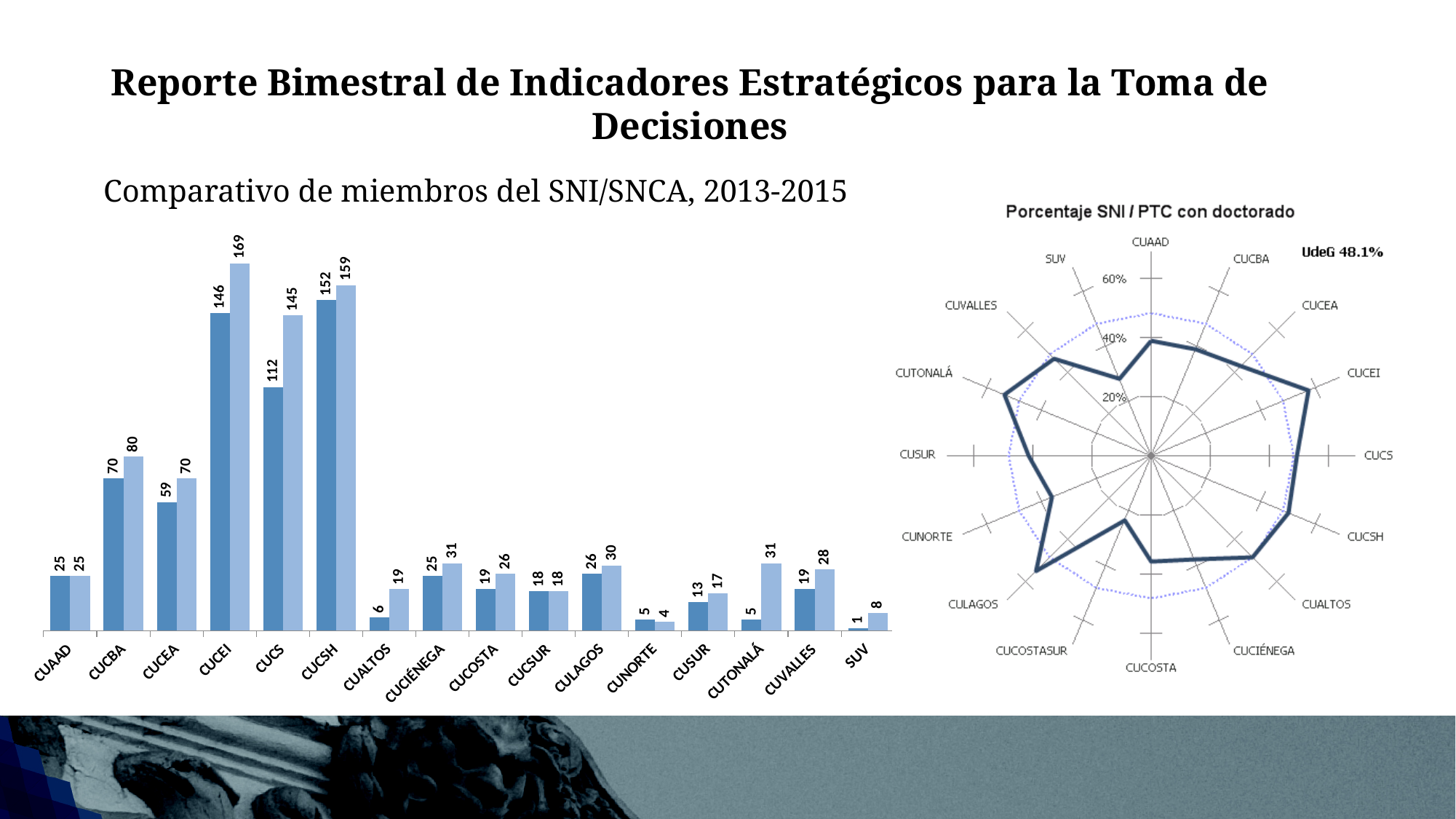
In the bar chart 'Comparativo de miembros del SNI/SNCA, 2013-2015', what is the value of the lighter blue bar for CUCEI? 169 In the bar chart 'Comparativo de miembros del SNI/SNCA, 2013-2015', how many categories are shown on the x axis? 16 In the bar chart 'Comparativo de miembros del SNI/SNCA, 2013-2015', what is the value of the darker blue bar for CUCS? 112 In the bar chart 'Comparativo de miembros del SNI/SNCA, 2013-2015', which category has the highest lighter blue bar? CUCEI In the bar chart 'Comparativo de miembros del SNI/SNCA, 2013-2015', what is the difference between the lighter blue and darker blue bars for CUCS? 33 In the bar chart 'Comparativo de miembros del SNI/SNCA, 2013-2015', which category has the lowest darker blue bar? SUV What kind of chart is 'Comparativo de miembros del SNI/SNCA, 2013-2015'? bar chart In the bar chart 'Comparativo de miembros del SNI/SNCA, 2013-2015', which is larger for CUNORTE: the darker blue bar or the lighter blue bar? the darker blue bar In the radar chart 'Porcentaje SNI / PTC con doctorado', is the value for CUCEI greater or less than 40%? greater What kind of chart is 'Porcentaje SNI / PTC con doctorado'? radar chart In the radar chart 'Porcentaje SNI / PTC con doctorado', what overall UdeG percentage is printed on the chart? 48.1% In the bar chart 'Comparativo de miembros del SNI/SNCA, 2013-2015', what is the value of the lighter blue bar for CUTONALÁ? 31